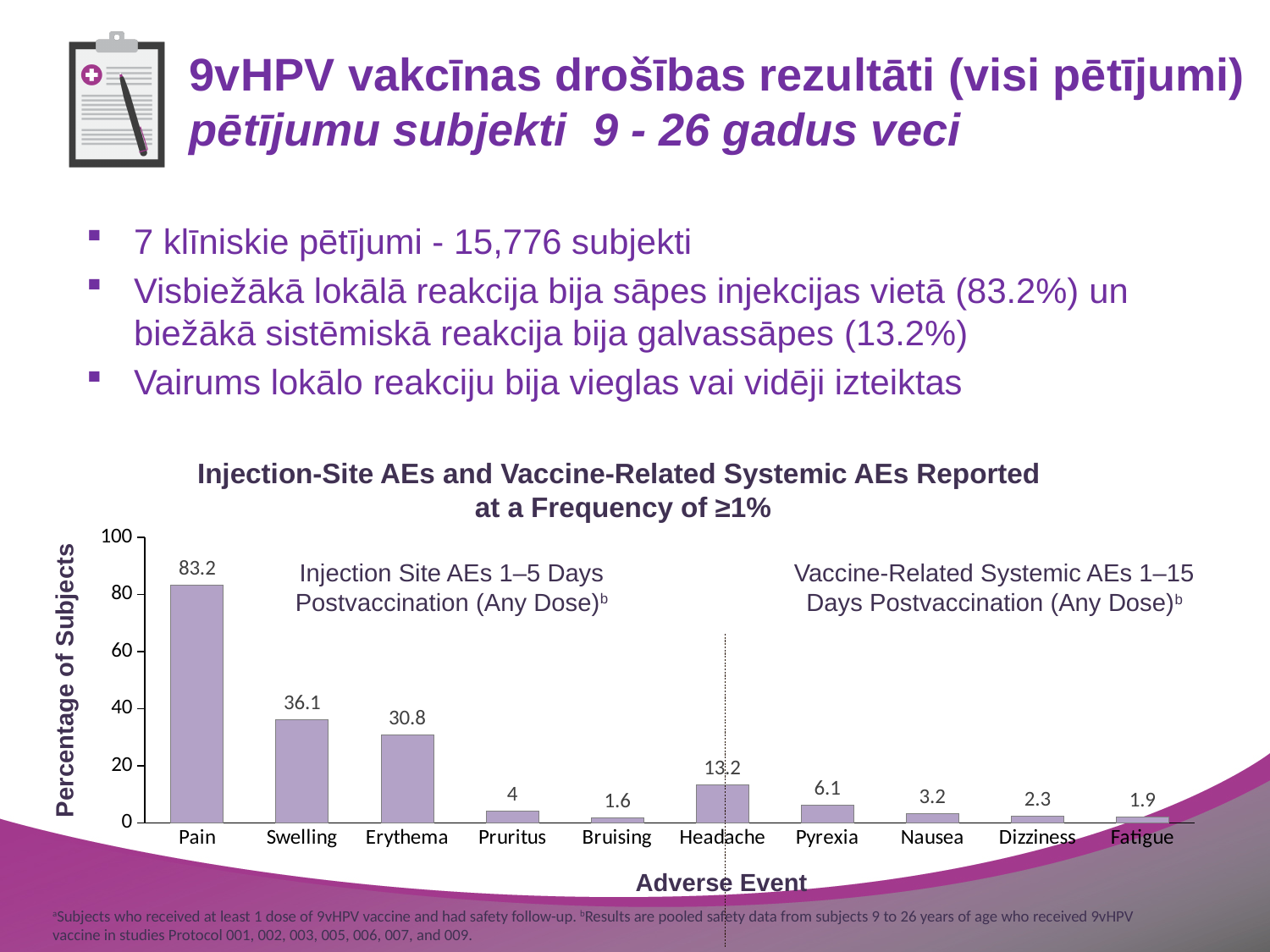
Which adverse event has the lowest percentage of subjects? Bruising What is the value for Headache in the chart? 13.2 What is the label of the vertical axis of the chart? Percentage of Subjects What is the value for Erythema in the chart? 30.8 What is the value for Pain in the chart? 83.2 Which adverse event has the highest percentage of subjects? Pain What is the difference between the values for Headache and Pyrexia? 7.1 What is the difference between the values for Swelling and Erythema? 5.3 What kind of chart is shown on the slide? Bar chart Which is larger, the value for Nausea or the value for Dizziness? Nausea How many adverse event categories are shown on the x axis? 10 Is the value for Swelling greater or less than 40? less